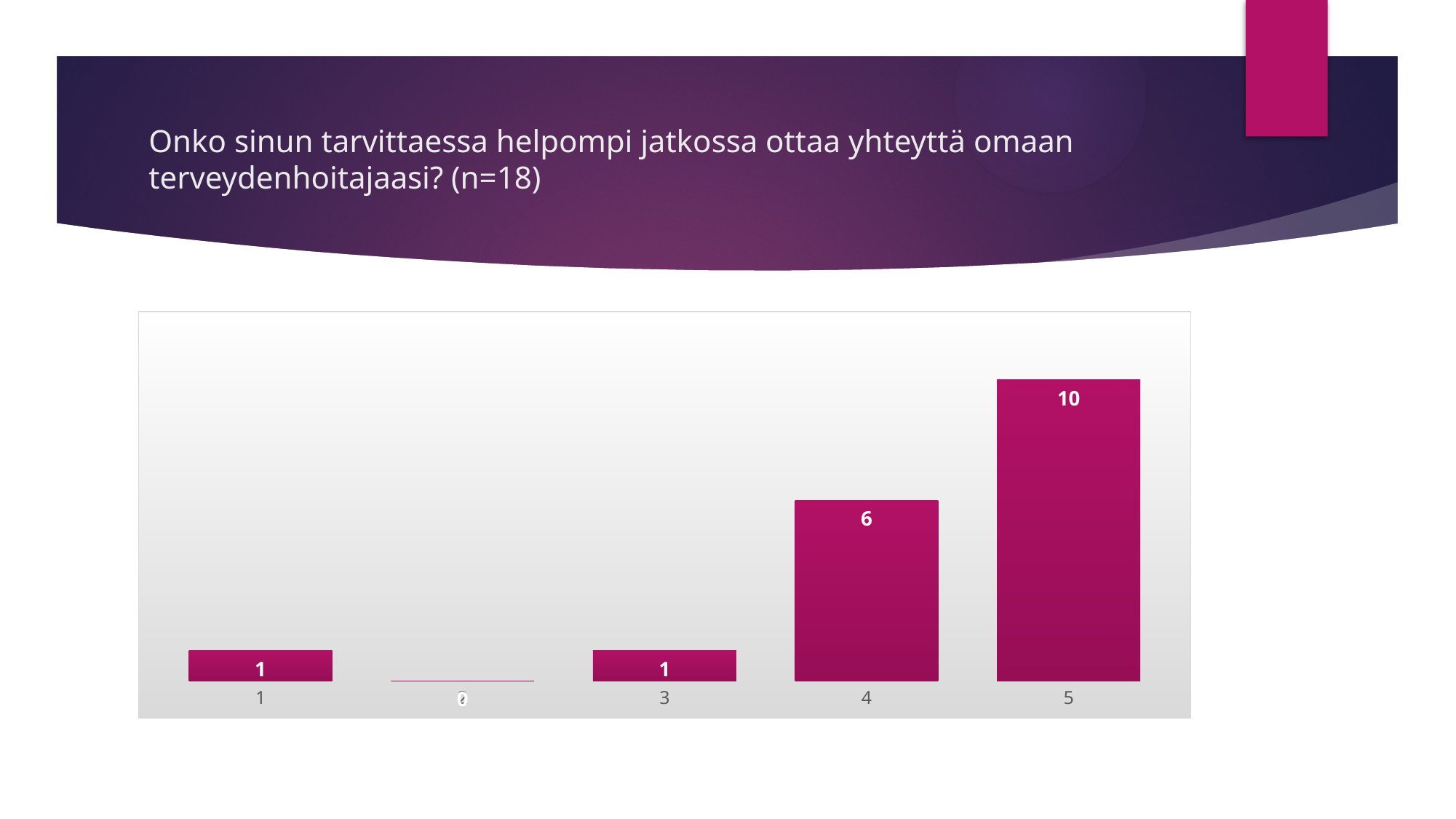
What is the difference between the values for category 5 and category 4? 4 What is the value for category 5? 10 What kind of chart is shown on the slide? bar chart How many categories are shown on the x axis? 5 What is the value for category 3? 1 What is the sample size (n) given in the slide title? 18 Which is larger, the value for category 1 or the value for category 4? 4 Which category has the highest value? 5 What is the value for category 1? 1 What is the difference between the values for category 4 and category 3? 5 What is the value for category 4? 6 Which is larger, the value for category 4 or the value for category 5? 5